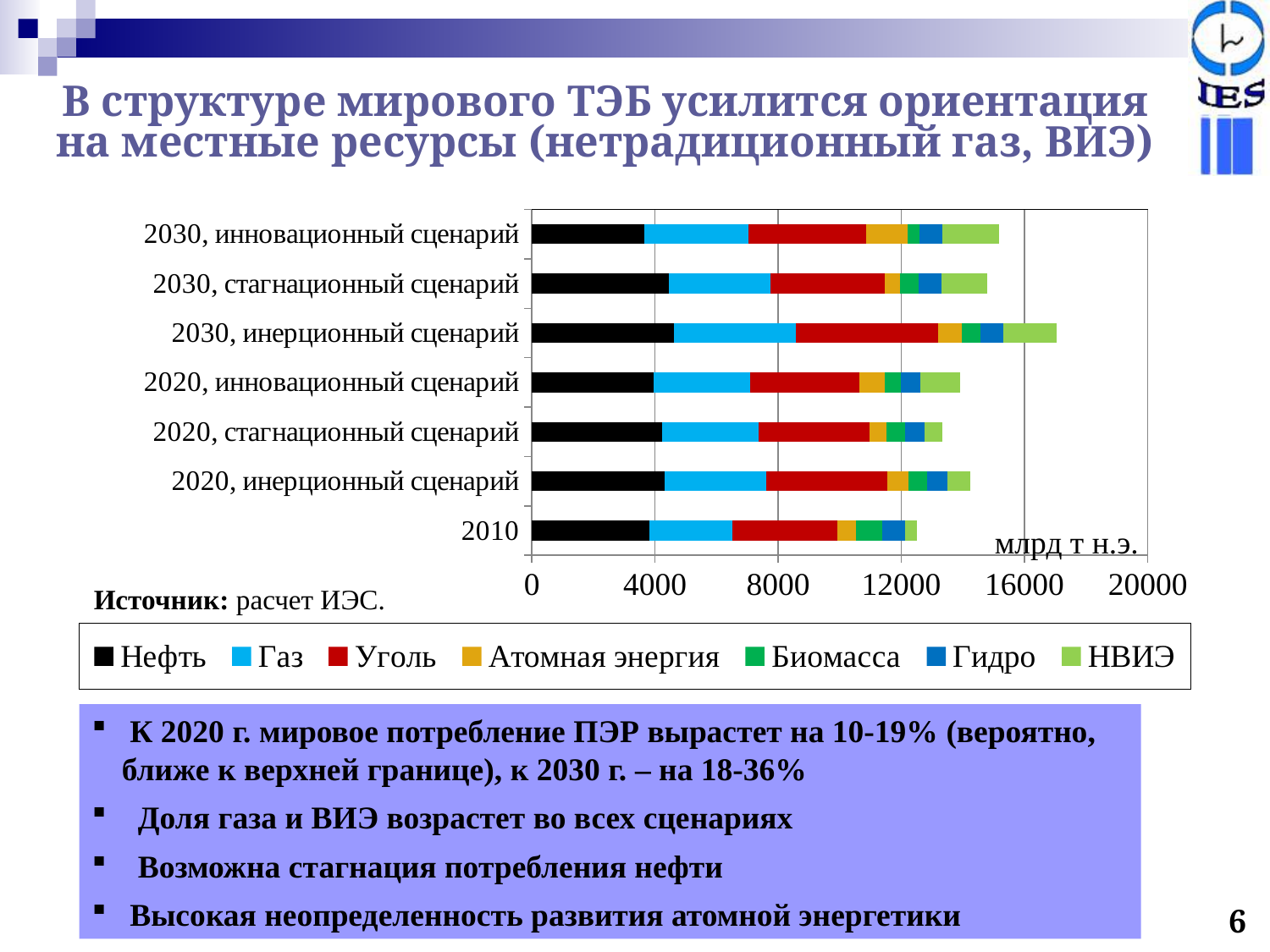
How many categories (scenario bars) are plotted on the chart? 7 Is the total value for 2010 greater or less than 16000? less Is the total value for 2030, инерционный сценарий greater or less than 16000? greater Is the total value for 2030, инновационный сценарий greater or less than 12000? greater Which category has the longest total bar? 2030, инерционный сценарий What unit label is shown next to the horizontal axis of the chart? млрд т н.э. Which category has the shortest total bar? 2010 What kind of chart is shown on the slide? Stacked horizontal bar chart Which has the larger total bar: 2010 or 2020, инерционный сценарий? 2020, инерционный сценарий How many series does the chart legend list? 7 Which has the larger total bar: 2030, инерционный сценарий or 2030, стагнационный сценарий? 2030, инерционный сценарий